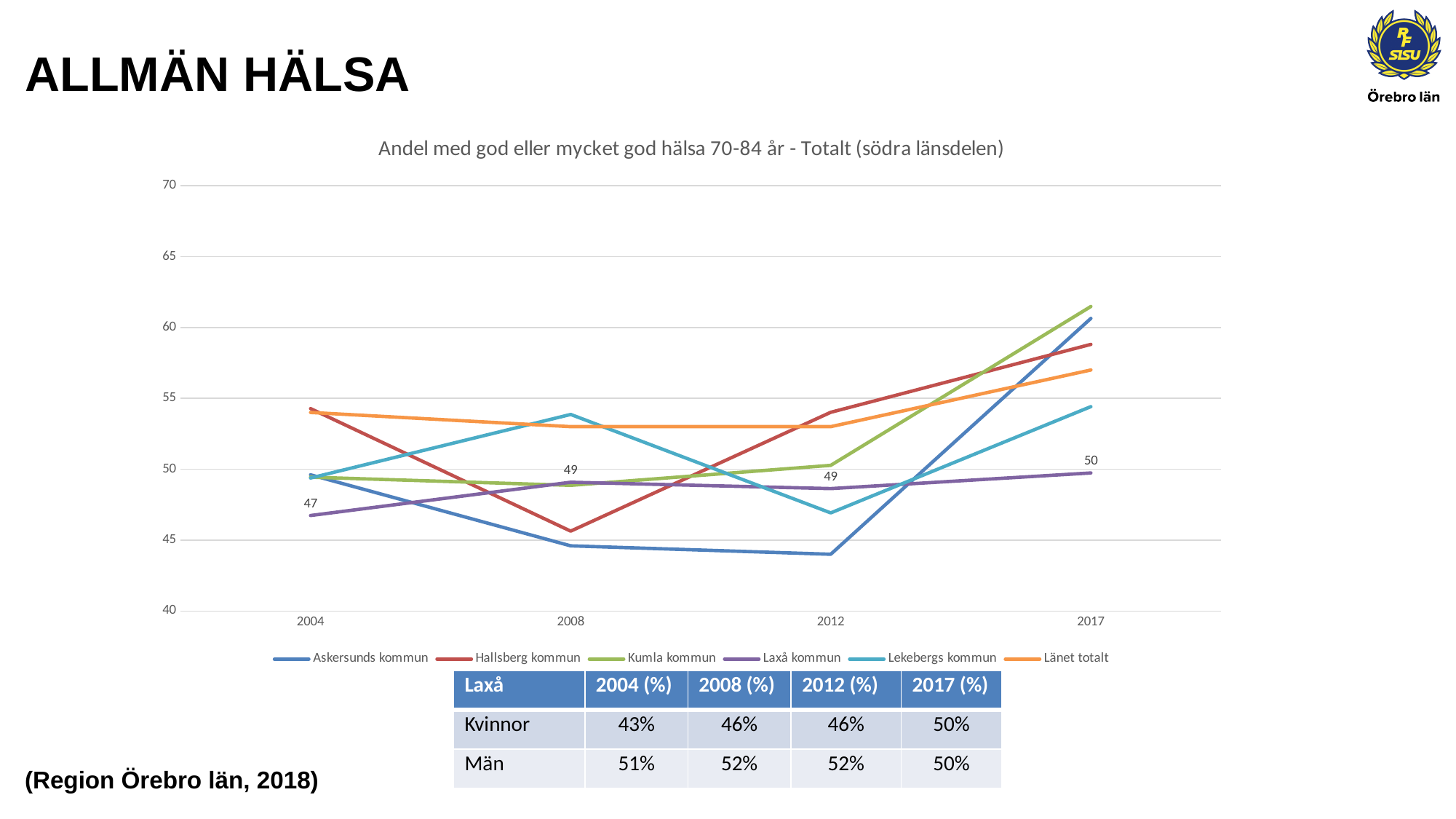
Is the value for Kumla kommun in 2017 greater or less than 60? greater What is the value for Laxå kommun in 2017? 50 Which series has the lowest value in 2012? Askersunds kommun In 2012, which is larger: Hallsberg kommun or Lekebergs kommun? Hallsberg kommun What is the value for Laxå kommun in 2008? 49 Does the value for Laxå kommun rise or fall from 2004 to 2017? rise Is the value for Askersunds kommun in 2012 greater or less than 45? less What kind of chart is shown on the slide? line chart How many years are shown on the x axis? 4 How many series does the legend list? 6 What is the value for Laxå kommun in 2004? 47 By how much did the value for Laxå kommun increase from 2004 to 2017? 3